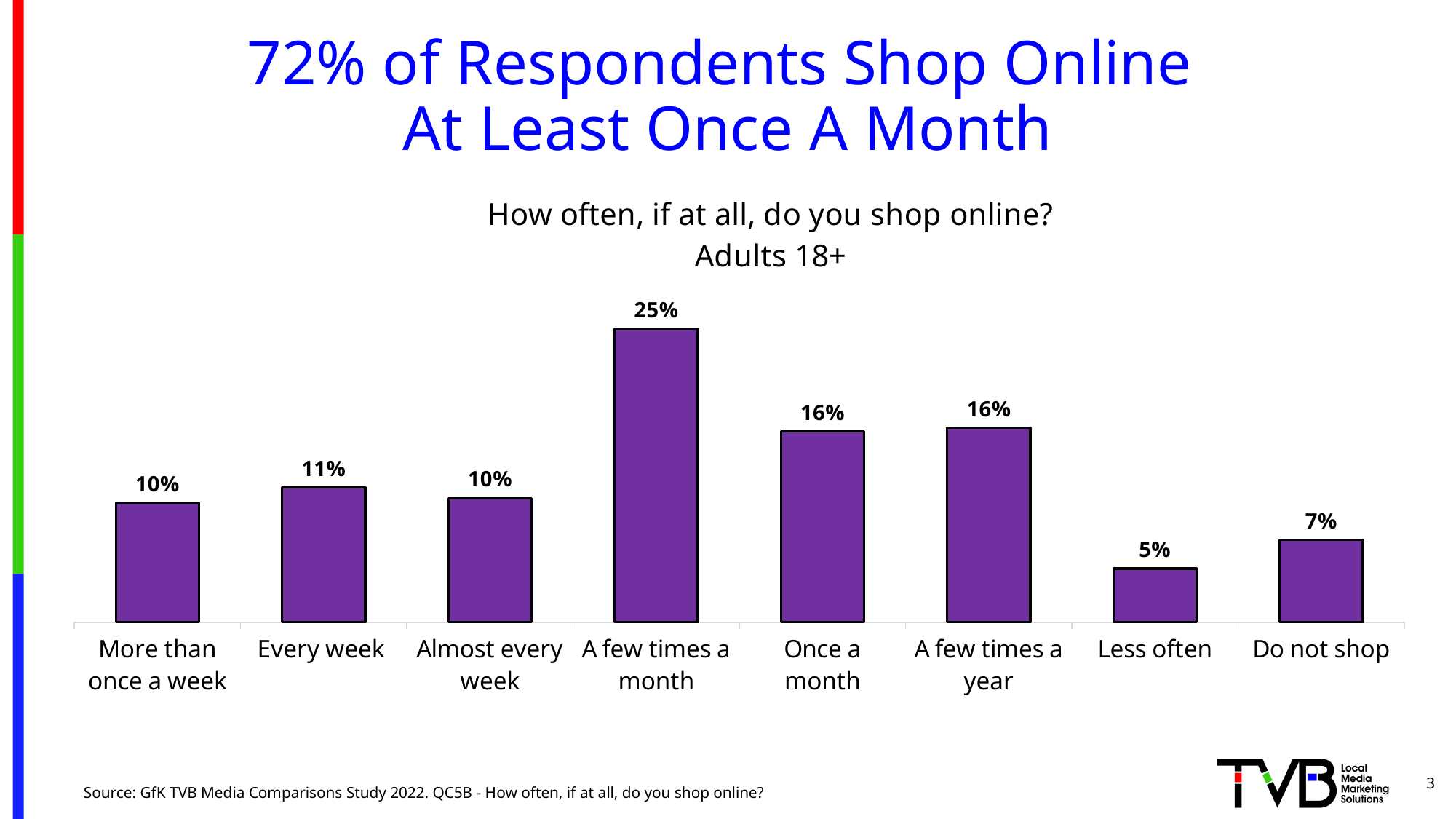
Which category has the highest percentage of respondents? A few times a month What is the combined percentage for 'Once a month' and 'A few times a year'? 32% What is the difference in percentage points between 'A few times a month' and 'Once a month'? 9 What percentage of respondents do not shop online? 7% What is the title of the chart? How often, if at all, do you shop online? Adults 18+ What percentage of respondents shop online a few times a month? 25% Which category has the lowest percentage of respondents? Less often What percentage of respondents shop online less often? 5% How many categories are shown on the x axis of the chart? 8 What percentage of respondents shop online every week? 11% Which is larger: the value for 'Every week' or the value for 'Do not shop'? Every week What kind of chart is shown on the slide? Bar chart